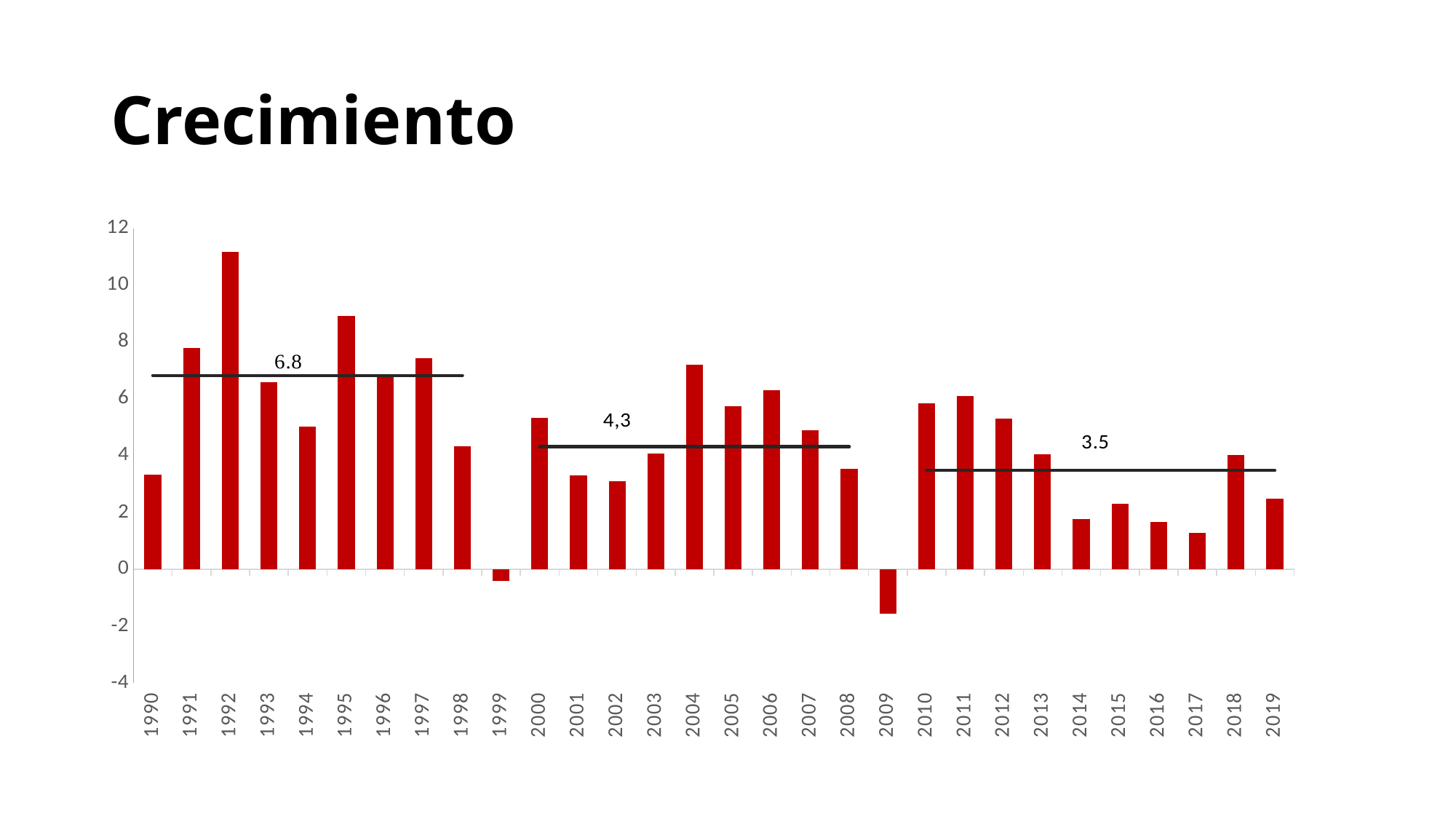
How many years (bars) are plotted on the chart? 30 Which year has the highest bar? 1992 What is the title of the chart? Crecimiento Is the value for 2017 greater or less than 2? less Is the value for 2009 greater or less than 0? less What value is written above the horizontal line spanning the 1990s bars? 6.8 Which is larger, the value for 2011 or the value for 2017? 2011 Is the value for 1992 greater or less than 10? greater Which year has the lowest bar? 2009 Which is larger, the value for 1992 or the value for 1995? 1992 What kind of chart is shown on the slide? bar chart